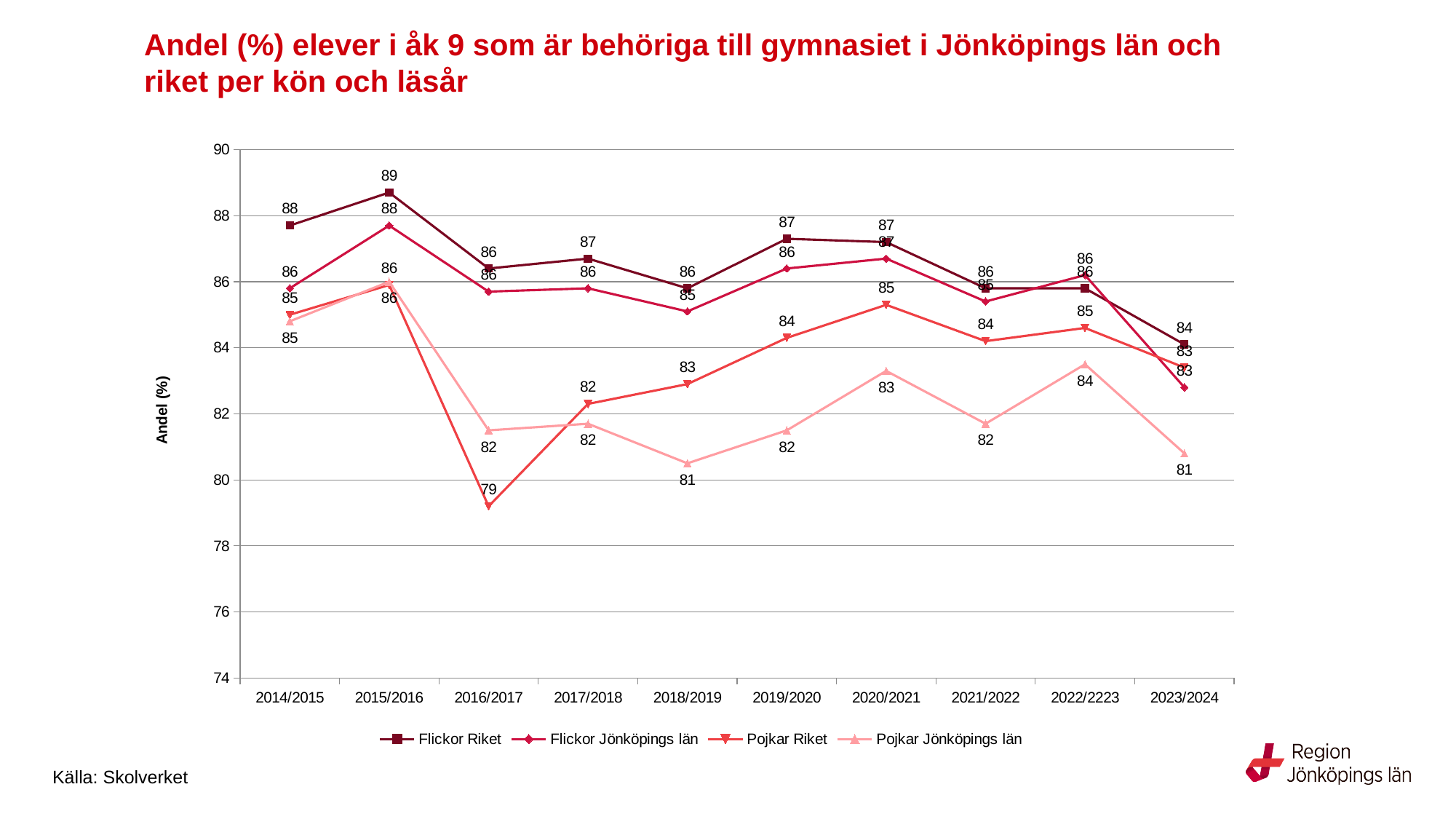
In 2018/2019, which is larger: Pojkar Riket or Pojkar Jönköpings län? Pojkar Riket What is the value for Flickor Riket in 2015/2016? 89 Is the value for Pojkar Jönköpings län in 2023/2024 greater or less than 82? less How many series does the legend list? 4 What is the difference between Flickor Riket and Pojkar Riket in 2016/2017? 7 In which school year is the value for Pojkar Riket lowest? 2016/2017 In which school year is the value for Flickor Riket highest? 2015/2016 How many school years (läsår) are plotted on the x axis? 10 What is the value for Pojkar Riket in 2016/2017? 79 What is the value for Pojkar Jönköpings län in 2022/2223? 84 What is the title of the y axis? Andel (%) What kind of chart is shown on the slide? line chart